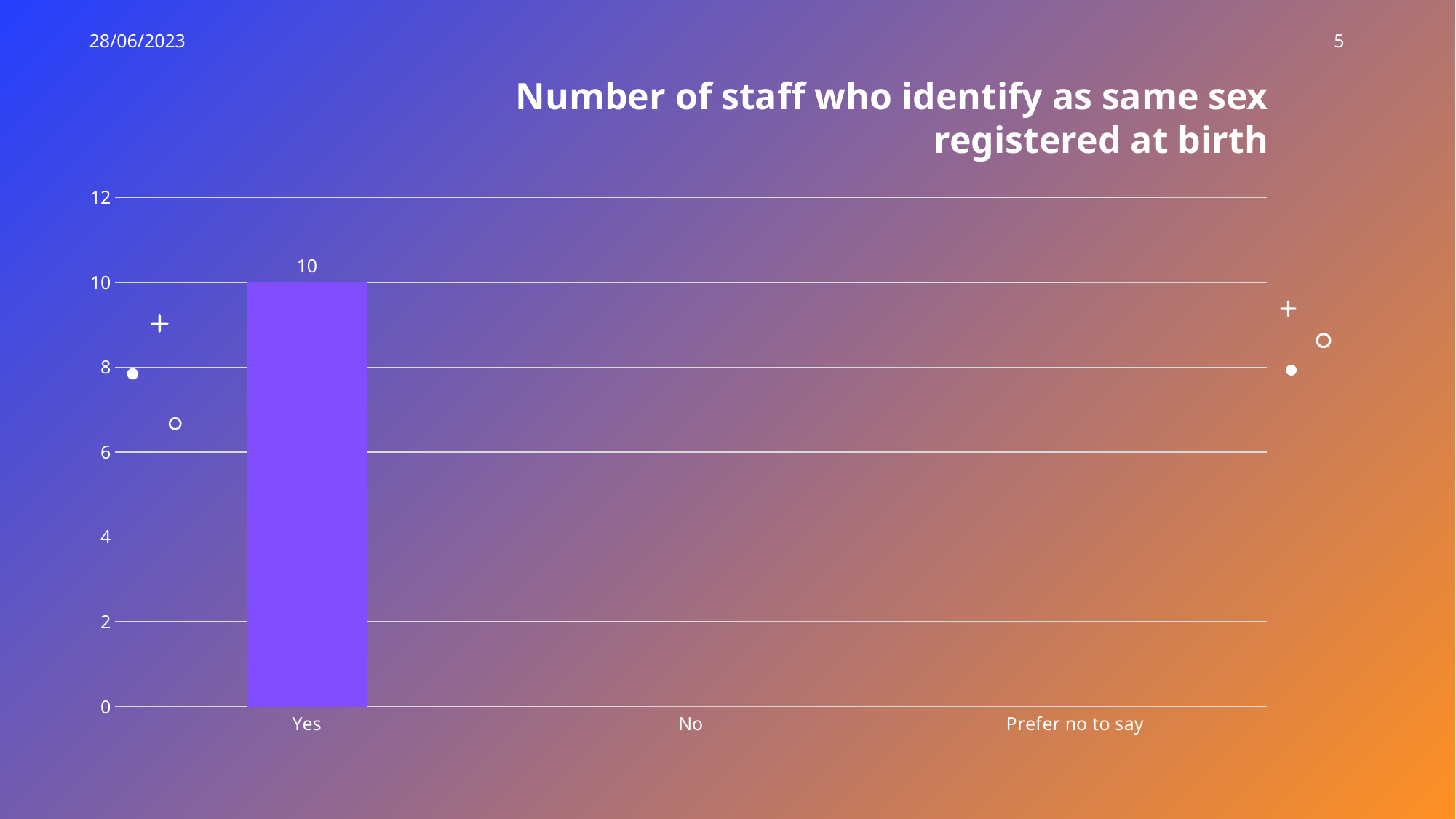
What is the title of the chart? Number of staff who identify as same sex registered at birth What is the value for Yes? 10 How many categories are shown on the x axis? 3 Is the value for Yes greater or less than 8? greater Which category has the highest value? Yes What kind of chart is this? bar chart What is the highest value shown on the y axis? 12